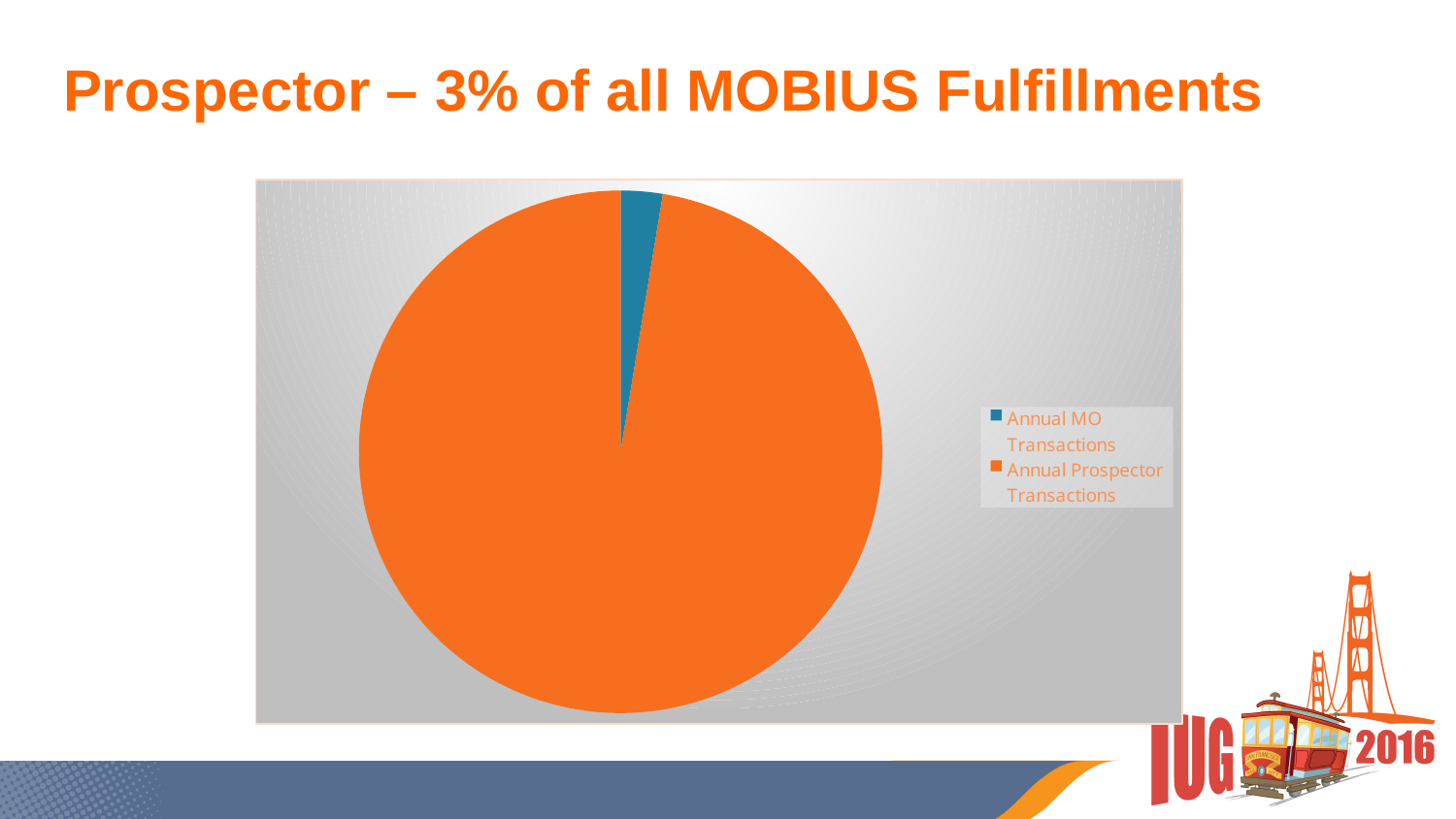
What kind of chart is shown on the slide? pie chart What colour is the Annual Prospector Transactions slice in the pie chart? orange Which slice is larger: Annual MO Transactions or Annual Prospector Transactions? Annual Prospector Transactions What colour is the Annual MO Transactions slice in the pie chart? blue How many entries does the legend of the pie chart list? 2 How many slices does the pie chart have? 2 Which category has the largest slice in the pie chart? Annual Prospector Transactions Which category has the smallest slice in the pie chart? Annual MO Transactions